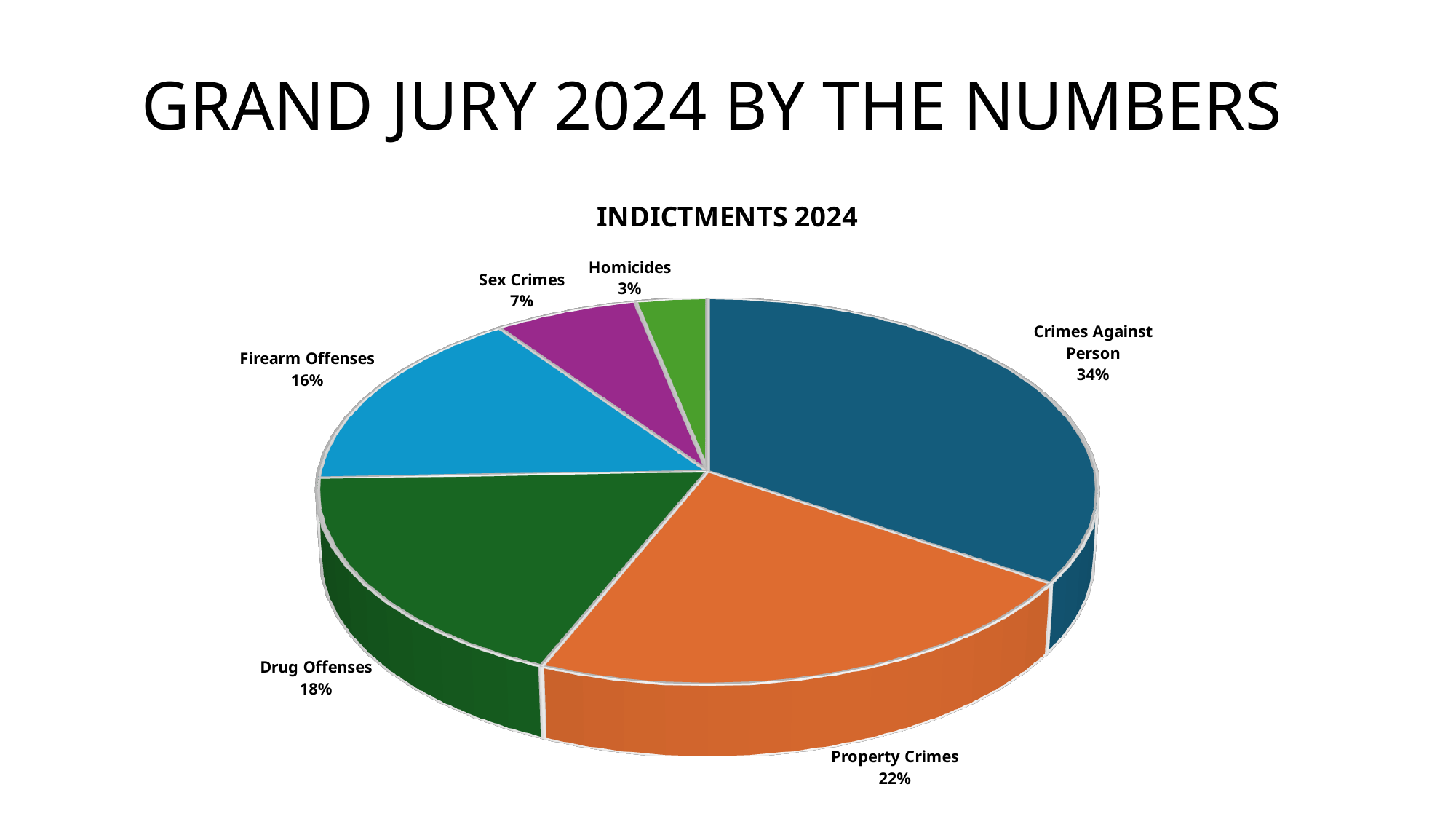
Which is larger, Drug Offenses or Firearm Offenses? Drug Offenses What share of the pie is Sex Crimes? 7% What kind of chart is shown on the slide? Pie chart What percentage of the pie is Property Crimes? 22% What is the difference in percentage points between Crimes Against Person and Property Crimes? 12 What share of indictments is Crimes Against Person? 34% Which category has the smallest slice of the pie? Homicides How many categories are shown in the pie chart? 6 What is the title of the chart? INDICTMENTS 2024 What percentage is shown for Firearm Offenses? 16% Which category has the largest slice of the pie? Crimes Against Person What is the value shown for Drug Offenses? 18%